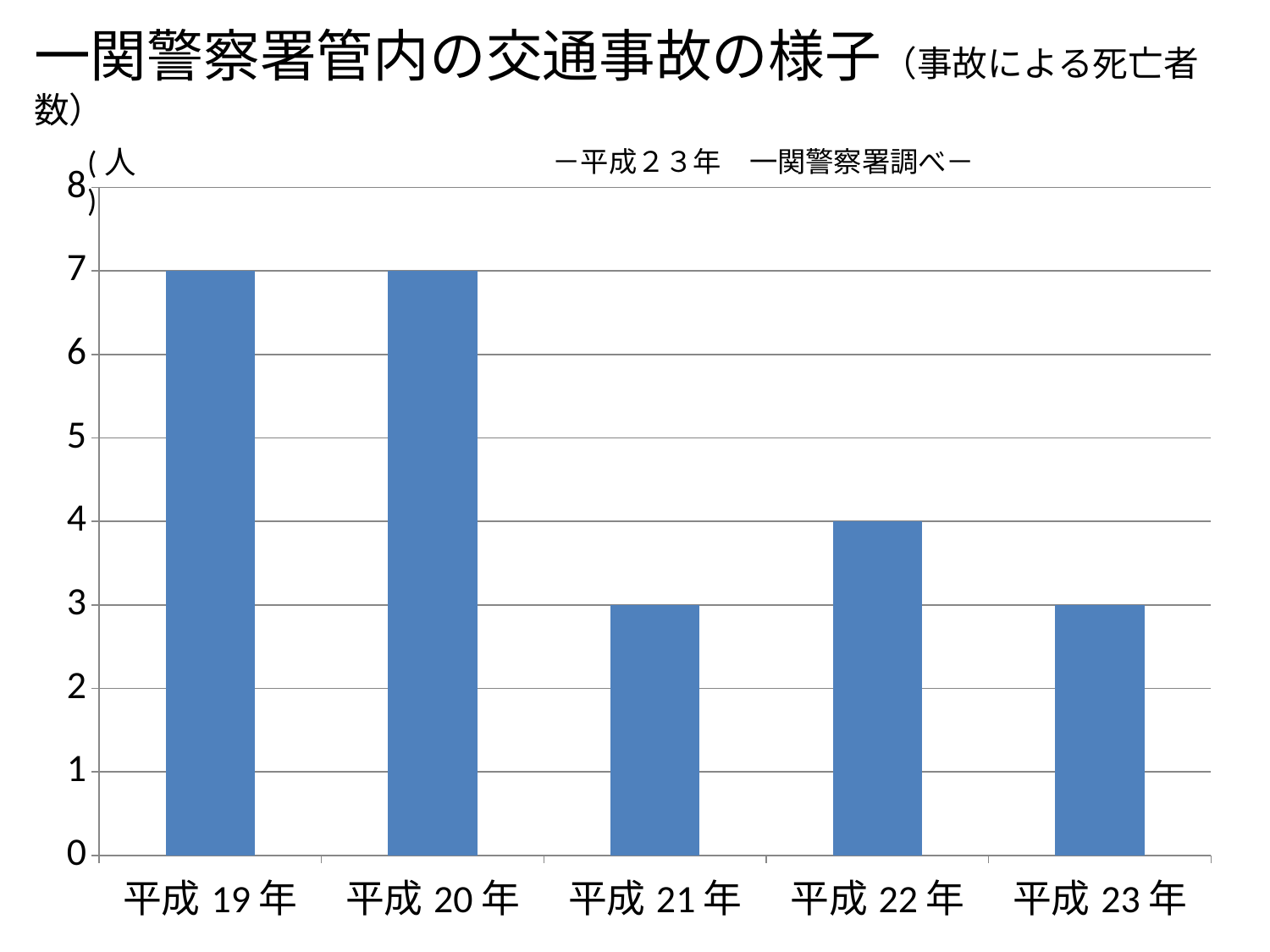
Is the value for 平成20年 greater or less than 5? greater Which is larger, the value for 平成19年 or the value for 平成22年? 平成19年 Do the values generally rise or fall from 平成19年 to 平成23年? fall What is the value for 平成21年? 3 How many categories are shown on the x axis? 5 What unit is shown on the y axis? 人 What is the value for 平成19年? 7 What is the difference between the values for 平成22年 and 平成23年? 1 What is the value for 平成22年? 4 What is the value for 平成23年? 3 What kind of chart is shown on the slide? bar chart What is the difference between the values for 平成20年 and 平成21年? 4